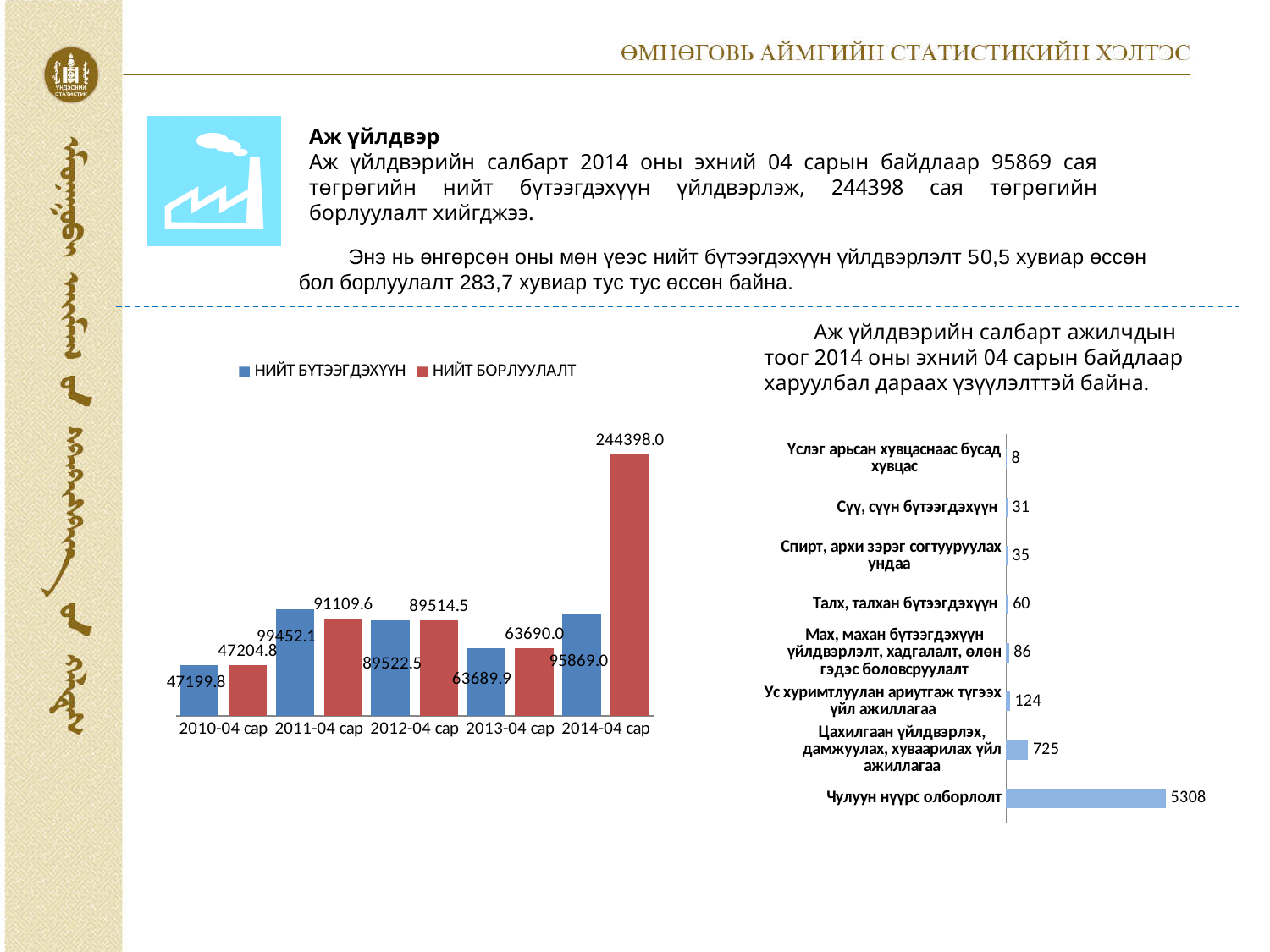
In the chart on the left, how many series does the legend list? 2 In the chart on the left, which category has the lowest value for НИЙТ БҮТЭЭГДЭХҮҮН? 2010-04 сар In the chart on the left, what is the value of НИЙТ БҮТЭЭГДЭХҮҮН for 2011-04 сар? 99452.1 In the chart on the left, what is the value of НИЙТ БОРЛУУЛАЛТ for 2014-04 сар? 244398.0 In the chart on the right, which category has the highest value? Чулуун нүүрс олборлолт In the chart on the left, what is the value of НИЙТ БҮТЭЭГДЭХҮҮН for 2013-04 сар? 63689.9 In the chart on the left, what is the difference between НИЙТ БОРЛУУЛАЛТ and НИЙТ БҮТЭЭГДЭХҮҮН for 2014-04 сар? 148529.0 In the chart on the left, which is larger for 2011-04 сар: НИЙТ БҮТЭЭГДЭХҮҮН or НИЙТ БОРЛУУЛАЛТ? НИЙТ БҮТЭЭГДЭХҮҮН In the chart on the left, how many categories are shown on the x axis? 5 In the chart on the right, what is the value for Талх, талхан бүтээгдэхүүн? 60 In the chart on the right, how many categories are shown? 8 What kind of chart is the chart on the right? Bar chart